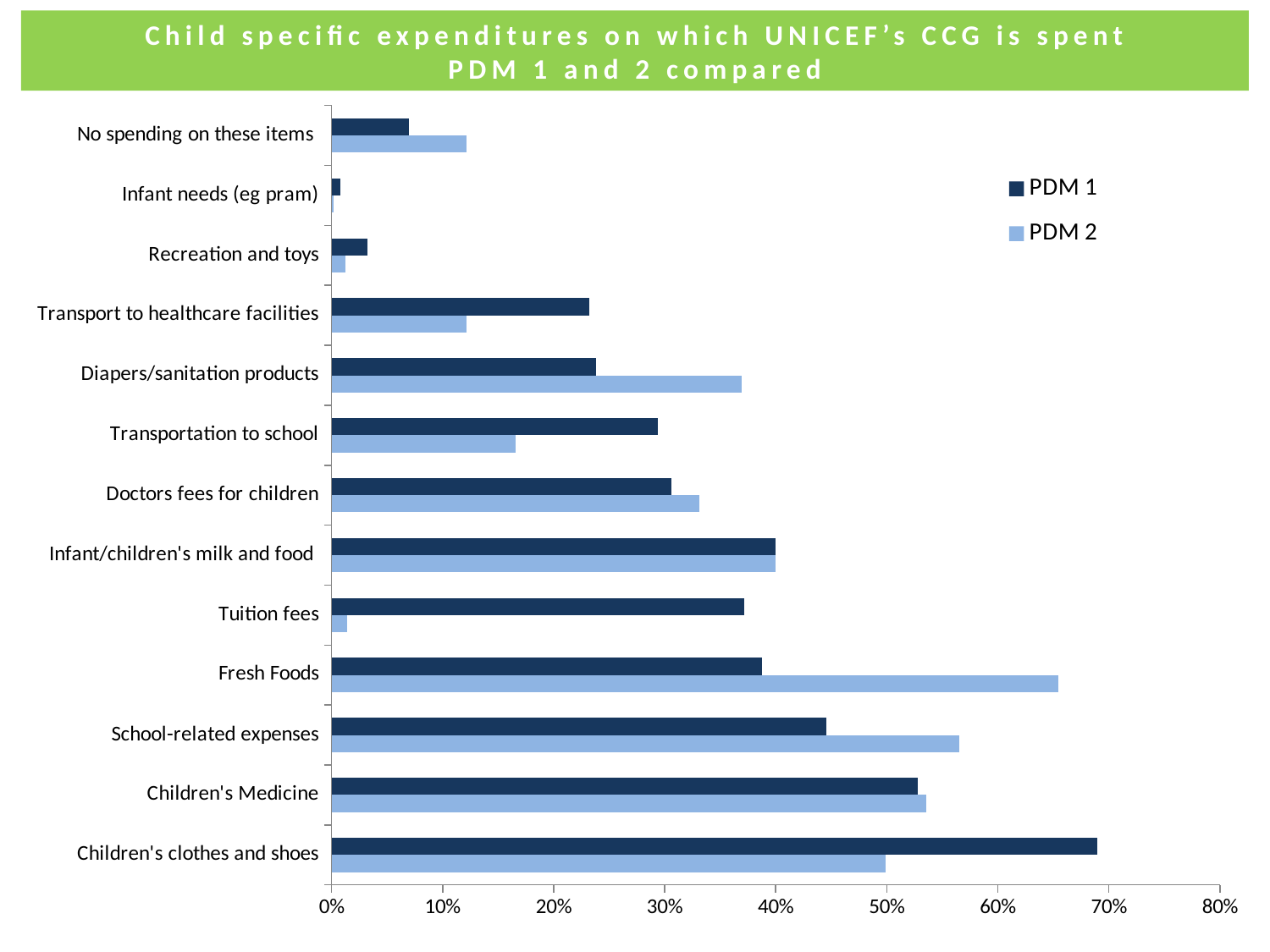
What is the title of the chart? Child specific expenditures on which UNICEF's CCG is spent PDM 1 and 2 compared For Fresh Foods, which series has the larger value, PDM 1 or PDM 2? PDM 2 Is the PDM 2 value for Tuition fees greater or less than 10%? less How many series does the legend list? 2 For Tuition fees, which series has the larger value, PDM 1 or PDM 2? PDM 1 Is the PDM 2 value for Fresh Foods greater or less than 60%? greater Is the PDM 2 value for Diapers/sanitation products greater or less than 30%? greater What kind of chart is shown on the slide? bar chart Which category has the lowest PDM 1 value? Infant needs (eg pram) How many categories are plotted on the chart? 13 Which category has the highest PDM 1 value? Children's clothes and shoes Which category has the highest PDM 2 value? Fresh Foods